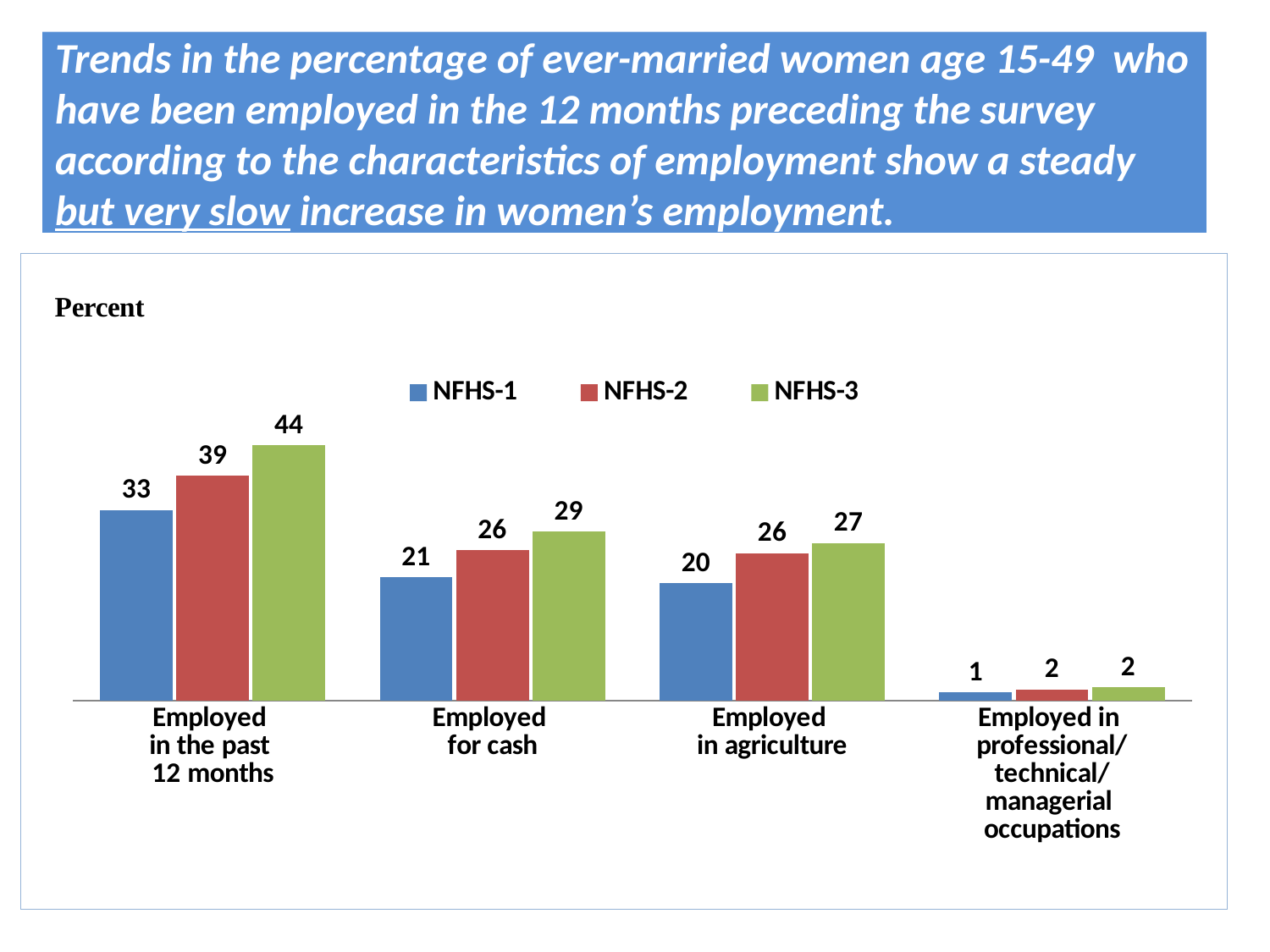
What is the NFHS-1 value for 'Employed in professional/technical/managerial occupations'? 1 Which is larger: the NFHS-3 value for 'Employed for cash' or the NFHS-3 value for 'Employed in agriculture'? Employed for cash Which category has the highest NFHS-3 value? Employed in the past 12 months How many series does the legend list? 3 Which category has the lowest NFHS-1 value? Employed in professional/technical/managerial occupations What kind of chart is shown on the slide? Bar chart What is the NFHS-1 value for 'Employed for cash'? 21 What is the NFHS-3 value for 'Employed in the past 12 months'? 44 How many categories are shown on the x axis? 4 What is the difference between the NFHS-2 and NFHS-1 values for 'Employed for cash'? 5 What is the NFHS-2 value for 'Employed in agriculture'? 26 What is the difference between the NFHS-3 and NFHS-1 values for 'Employed in the past 12 months'? 11